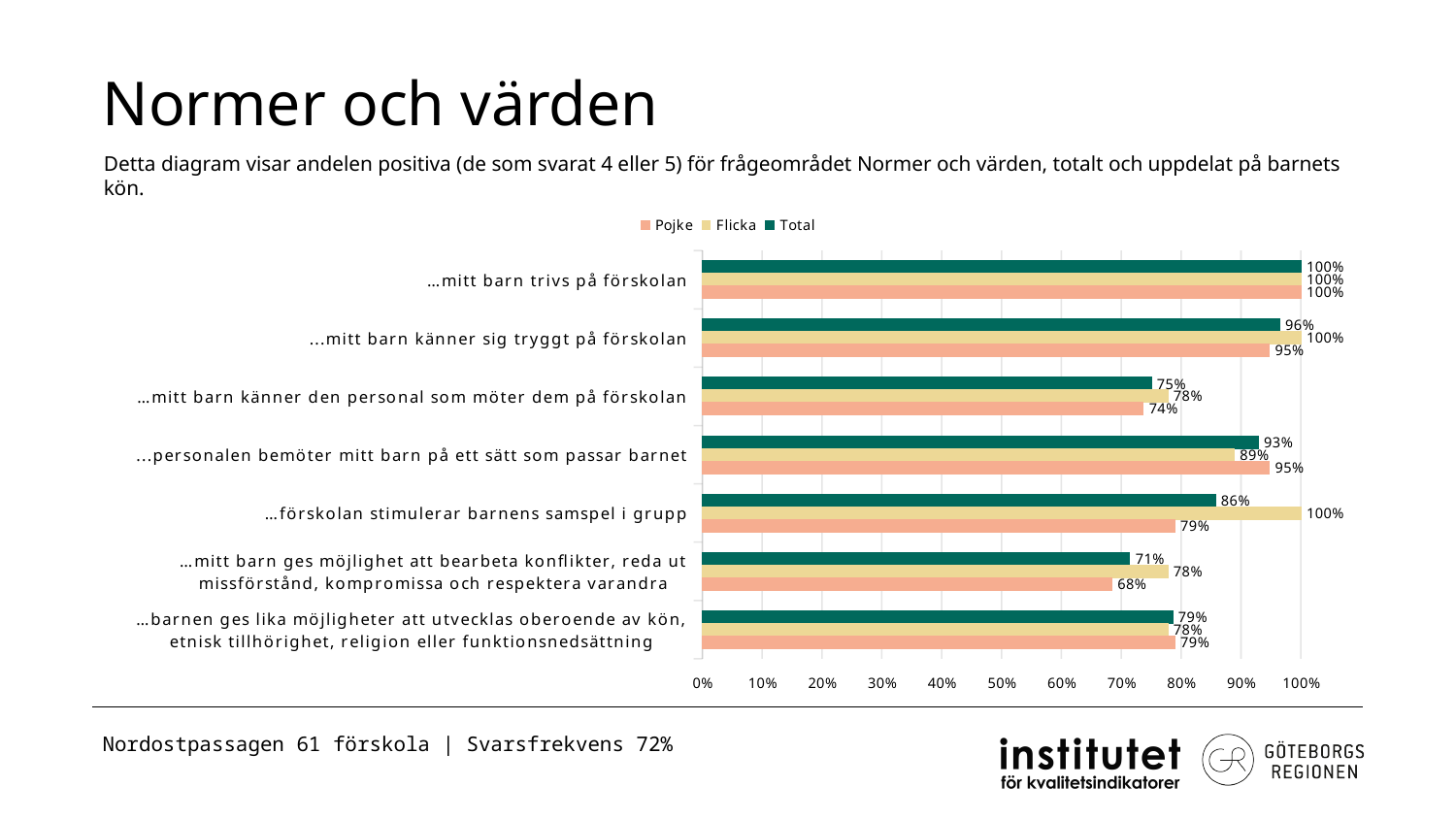
Which category has the highest Pojke value? …mitt barn trivs på förskolan What is the Pojke value for "…förskolan stimulerar barnens samspel i grupp"? 79% Which category has the lowest Total value? …mitt barn ges möjlighet att bearbeta konflikter, reda ut missförstånd, kompromissa och respektera varandra How many series does the legend list? 3 For "…personalen bemöter mitt barn på ett sätt som passar barnet", which is larger, the Pojke value or the Flicka value? Pojke What kind of chart is shown on the slide? Bar chart Which series is shown in green in the chart? Total What is the Total value for "…mitt barn känner sig tryggt på förskolan"? 96% Is the Pojke value for "…mitt barn ges möjlighet att bearbeta konflikter, reda ut missförstånd, kompromissa och respektera varandra" greater or less than 70%? less How many categories are shown on the y axis of the chart? 7 What is the difference between the Flicka and Pojke values for "…förskolan stimulerar barnens samspel i grupp"? 21 percentage points What is the Flicka value for "…personalen bemöter mitt barn på ett sätt som passar barnet"? 89%